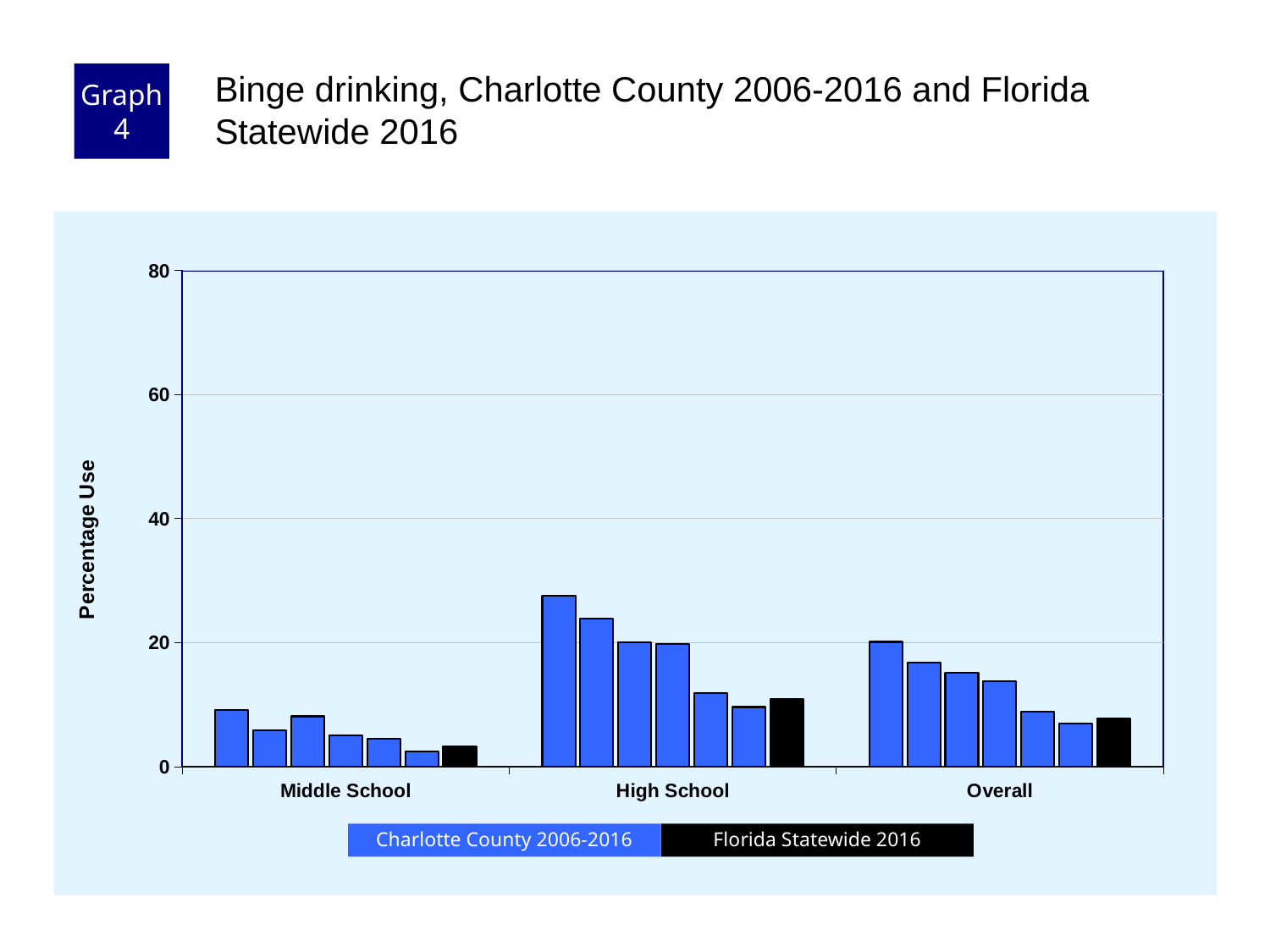
What is the label on the y axis? Percentage Use How many school-level categories are shown on the x axis? 3 What kind of chart is shown on the slide? bar chart Which category contains the shortest bars overall? Middle School Is the Florida Statewide 2016 value for High School greater or less than 20? less Which is larger, the Florida Statewide 2016 value for High School or for Middle School? High School Is the tallest Charlotte County bar for High School greater or less than 20? greater What is the title of the chart? Binge drinking, Charlotte County 2006-2016 and Florida Statewide 2016 How many series does the legend list? 2 Which category contains the tallest bar? High School Are all the Middle School bars greater or less than 20? less Within the High School group, do the Charlotte County 2006-2016 bars rise or fall from left to right? fall